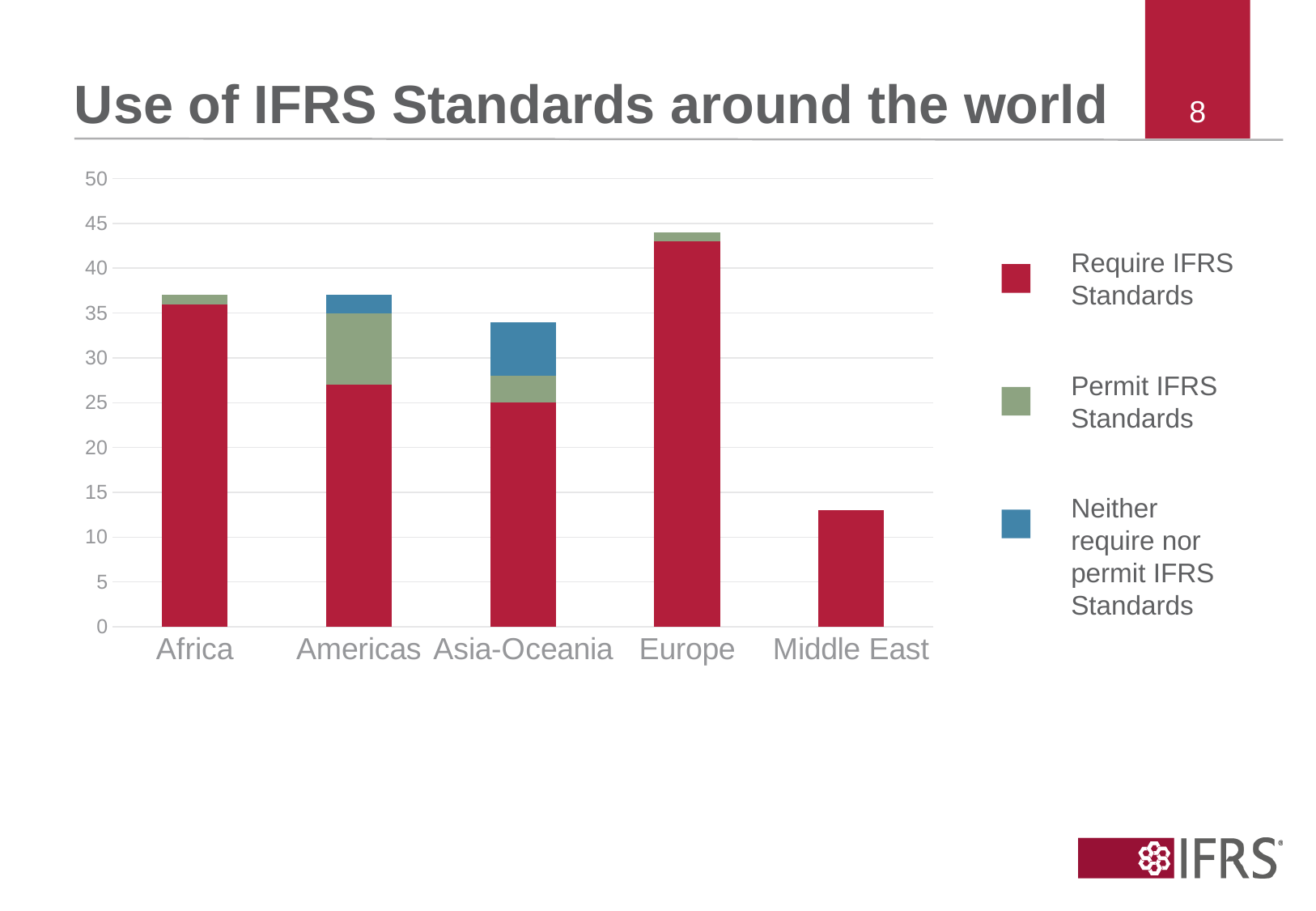
What kind of chart is shown on the slide? Stacked bar chart Is the total bar height for Asia-Oceania greater or less than 30? greater Which series is shown in blue in the legend? Neither require nor permit IFRS Standards How many regions are shown on the x axis of the chart? 5 Which has the larger total bar, Middle East or Asia-Oceania? Asia-Oceania Is the 'Require IFRS Standards' value for Americas greater or less than 30? less How many series does the chart's legend list? 3 Which region has the tallest stacked bar overall? Europe Is the total bar height for Europe greater or less than 40? greater Which region has the largest 'Require IFRS Standards' segment? Europe Which region has the shortest stacked bar overall? Middle East